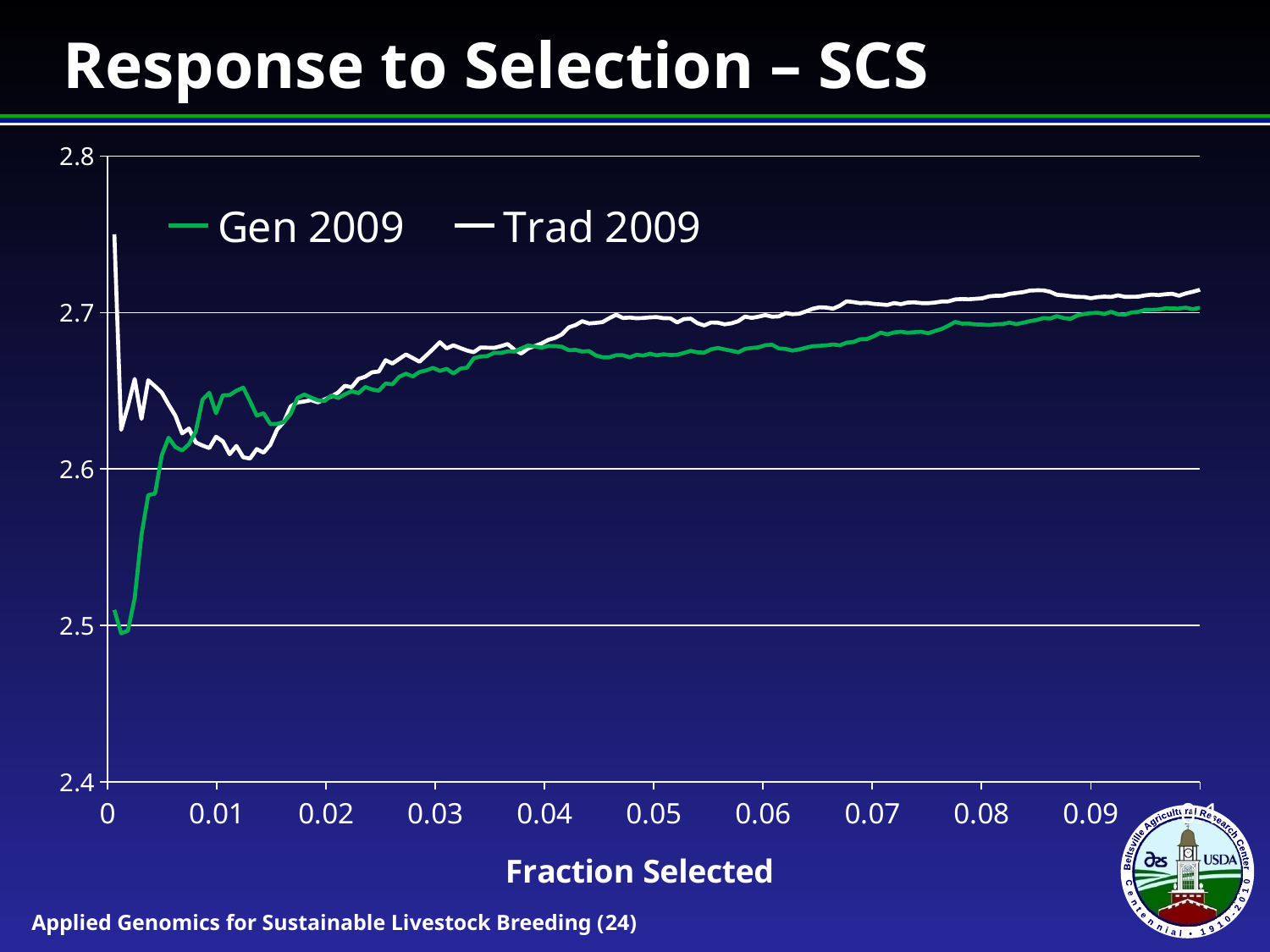
What is the label of the x axis? Fraction Selected Is the value of Gen 2009 at a fraction selected of 0.02 greater or less than 2.6? greater At a fraction selected of 0.01, which series has the higher value, Gen 2009 or Trad 2009? Gen 2009 What is the title of the chart? Response to Selection – SCS Overall, does the Gen 2009 line rise or fall as the fraction selected increases from 0.01 to 0.09? rise What kind of chart is shown on the slide? line chart At a fraction selected of 0.05, which series has the higher value, Gen 2009 or Trad 2009? Trad 2009 Is the value of Gen 2009 at a fraction selected of 0.05 greater or less than 2.7? less How many series does the legend list? 2 Which series is drawn in green? Gen 2009 Is the value of Trad 2009 at a fraction selected of 0.01 greater or less than 2.7? less